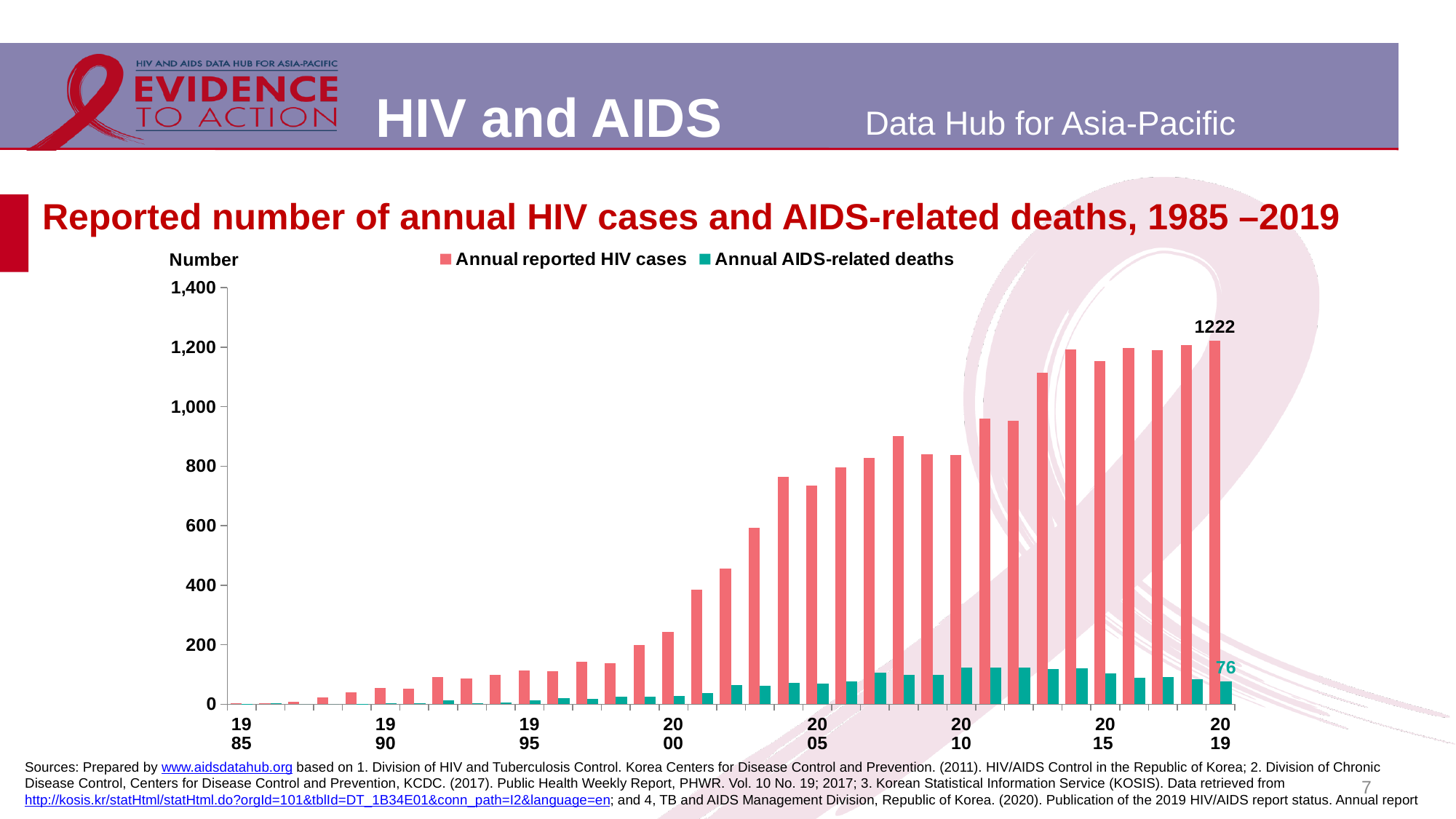
What is the number of annual AIDS-related deaths in 2019? 76 In 2019, which is larger: annual reported HIV cases or annual AIDS-related deaths? Annual reported HIV cases Is the value for annual reported HIV cases in 2010 greater or less than 600? greater Do annual reported HIV cases generally rise or fall from 1985 to 2019? Rise How many series does the legend list? 2 What is the number of annual reported HIV cases in 2019? 1222 What kind of chart is shown on the slide? Bar chart What is the label on the vertical axis of the chart? Number Which year has the highest number of annual reported HIV cases? 2019 Is the value for annual AIDS-related deaths in 2015 greater or less than 200? less Is the value for annual reported HIV cases in 2000 greater or less than 400? less What is the difference between annual reported HIV cases and annual AIDS-related deaths in 2019? 1146